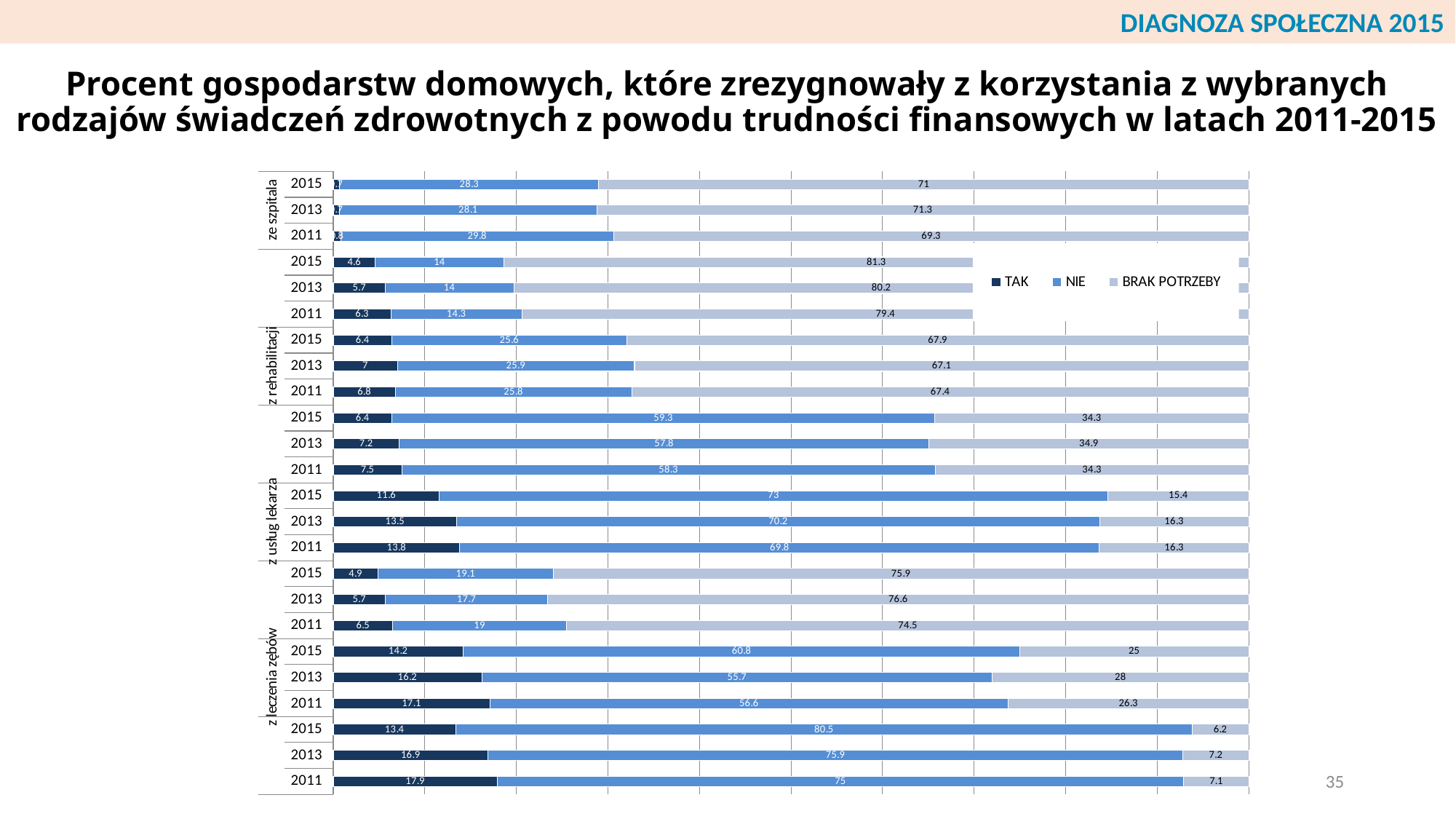
What is the total of the bottom stacked bar (2011) across TAK, NIE and BRAK POTRZEBY? 100 In the topmost group (ze szpitala), what is the difference between the BRAK POTRZEBY values for 2013 and 2011? 2 In the topmost group (ze szpitala), what is the BRAK POTRZEBY value for 2015? 71 In the bottom group of three bars, is the TAK value larger for 2011 or for 2015? 2011 In the topmost group (ze szpitala), what is the NIE value for 2011? 29.8 How many series does the legend list? 3 Among the bottom three bars (2015, 2013, 2011), which year has the highest NIE value? 2015 What is the NIE value for the bottom bar of the chart (2011)? 75 What is the TAK value for the bottom bar of the chart (2011)? 17.9 What is the BRAK POTRZEBY value for the bottom bar of the chart (2011)? 7.1 What are the three legend entries of the chart? TAK, NIE, BRAK POTRZEBY What kind of chart is shown on the slide? stacked bar chart